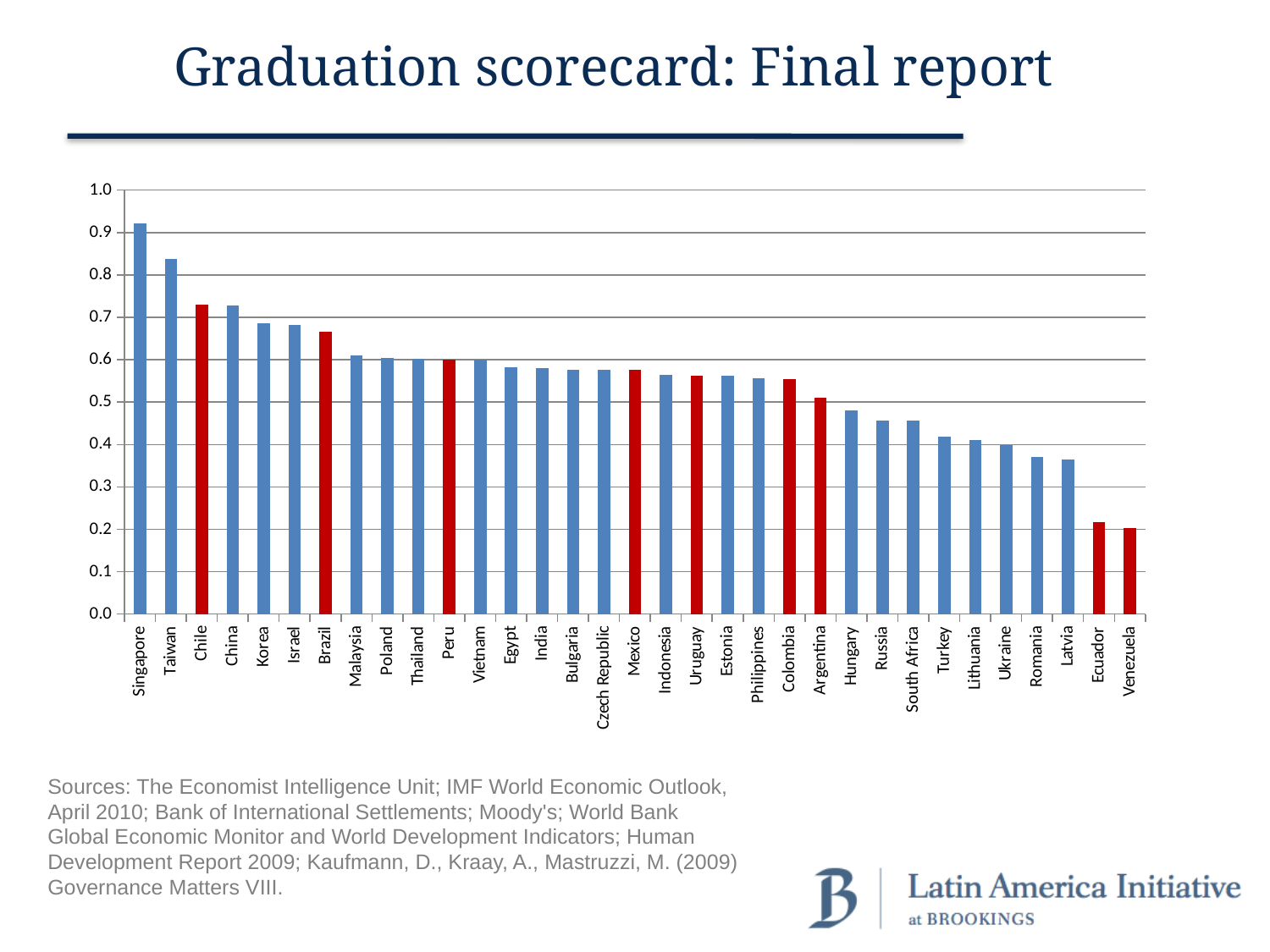
Do the values rise or fall moving from left to right along the x axis? Fall Which country has the lowest value in the chart? Venezuela Is the value for Brazil greater or less than 0.6? greater Is the value for Singapore greater or less than 0.9? greater Which country has the highest value in the chart? Singapore Is the value for Russia greater or less than 0.5? less What kind of chart is shown on the slide? Bar chart How many bars in the chart are coloured red? 9 Which has the larger value, Chile or Brazil? Chile How many countries are shown on the x axis of the chart? 33